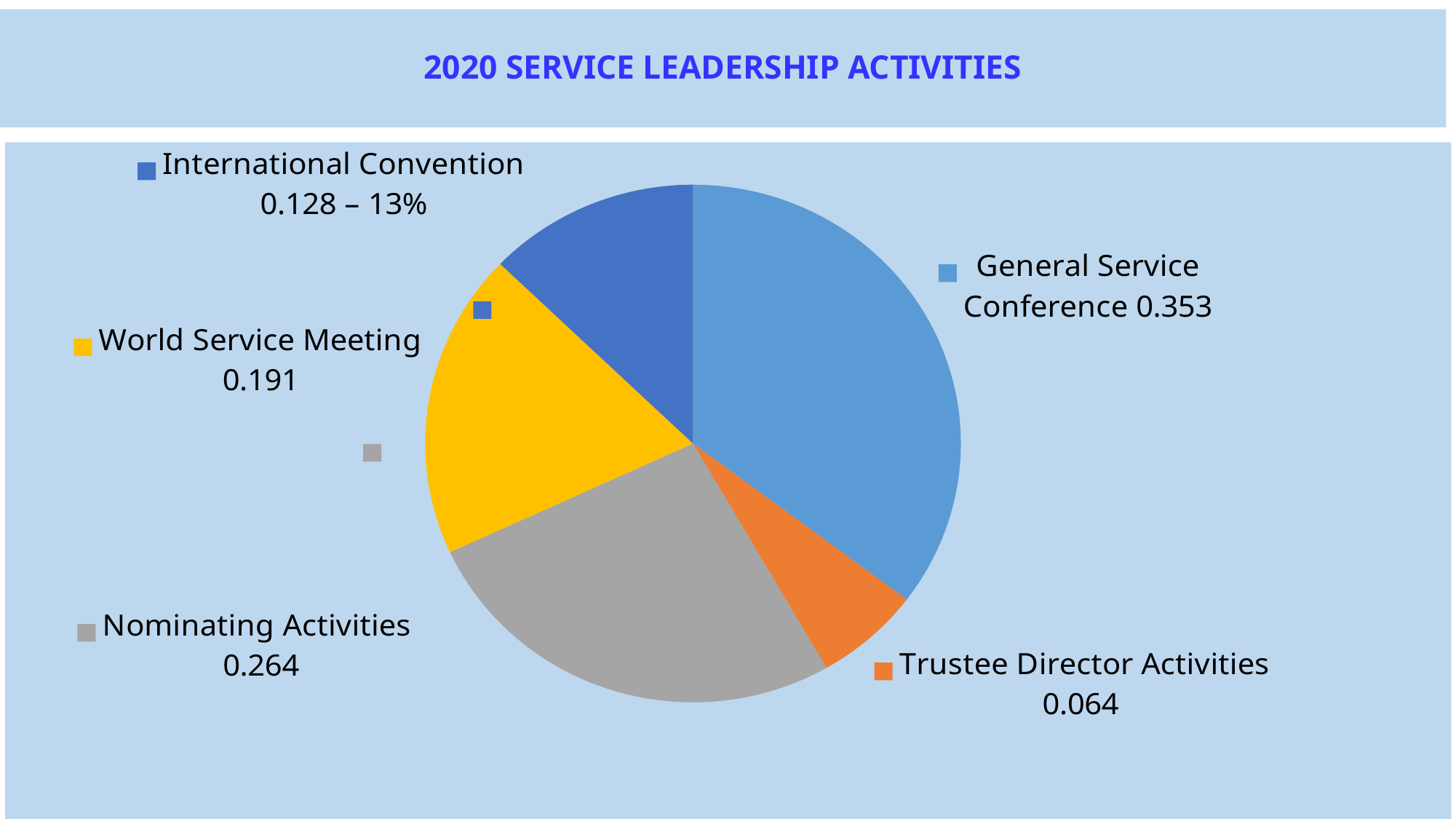
Which category has the smallest slice of the pie? Trustee Director Activities What is the value for General Service Conference? 0.353 Which is larger, World Service Meeting or International Convention? World Service Meeting What is the value for Nominating Activities? 0.264 What is the title of the chart? 2020 SERVICE LEADERSHIP ACTIVITIES What is the difference between the values for General Service Conference and Nominating Activities? 0.089 Which category has the largest slice of the pie? General Service Conference What is the value for World Service Meeting? 0.191 What is the value for Trustee Director Activities? 0.064 What is the value for International Convention? 0.128 What kind of chart is shown on the slide? Pie chart How many categories are shown in the pie chart? 5